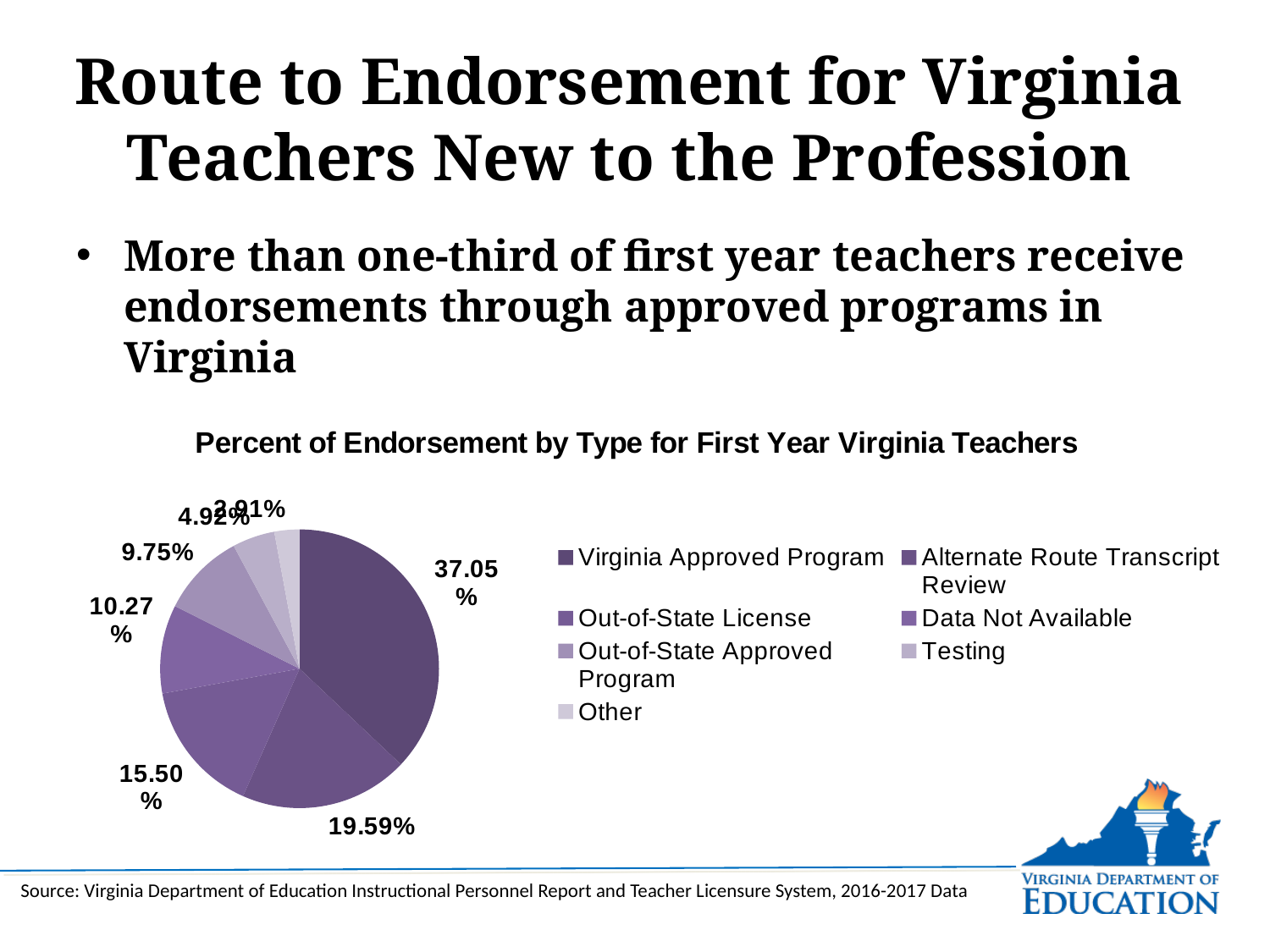
Is the share for Virginia Approved Program greater or less than 50% of the pie? less What percentage of endorsements is shown for Virginia Approved Program? 37.05% What is the largest percentage labelled on the pie chart? 37.05% How many categories does the chart's legend list? 7 What kind of chart is shown on the slide? Pie chart Which is larger, the slice labelled 15.50% or the slice labelled 10.27%? 15.50% What is the difference between the slices labelled 15.50% and 9.75%? 5.75% Which endorsement type has the largest share of the pie? Virginia Approved Program Which legend entry is listed last in the chart's legend? Other What is the second-largest percentage labelled on the pie chart? 19.59% What is the difference between the largest slice (37.05%) and the second-largest slice (19.59%)? 17.46% What is the title of the chart? Percent of Endorsement by Type for First Year Virginia Teachers